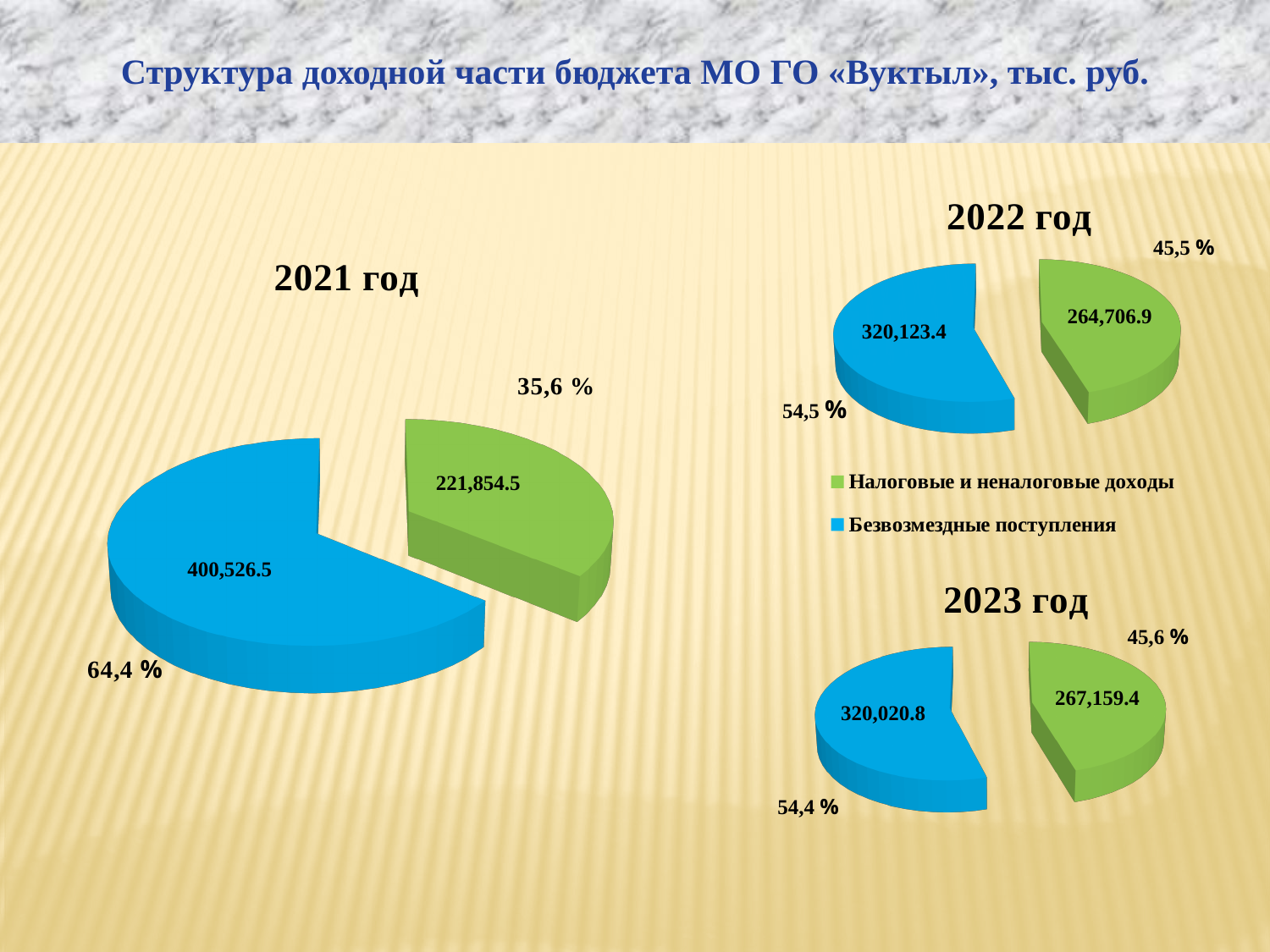
In the 2021 год chart, which category is the smallest? Налоговые и неналоговые доходы In the 2022 год chart, what is the difference between Безвозмездные поступления and Налоговые и неналоговые доходы? 55,416.5 In the 2023 год chart, what is the value for Безвозмездные поступления? 320,020.8 How many series does the legend list? 2 In the 2022 год chart, what is the value for Налоговые и неналоговые доходы? 264,706.9 In the 2023 год chart, what is the total of the two slices? 587,180.2 In the 2023 год chart, what share of the pie does Налоговые и неналоговые доходы take? 45,6 % In the 2021 год chart, what share of the pie does Безвозмездные поступления take? 64,4 % In the 2022 год chart, which category is the largest? Безвозмездные поступления In the 2021 год chart, what is the value for Безвозмездные поступления? 400,526.5 In the 2021 год chart, what is the value for Налоговые и неналоговые доходы? 221,854.5 What kind of chart is the 2021 год chart? Pie chart